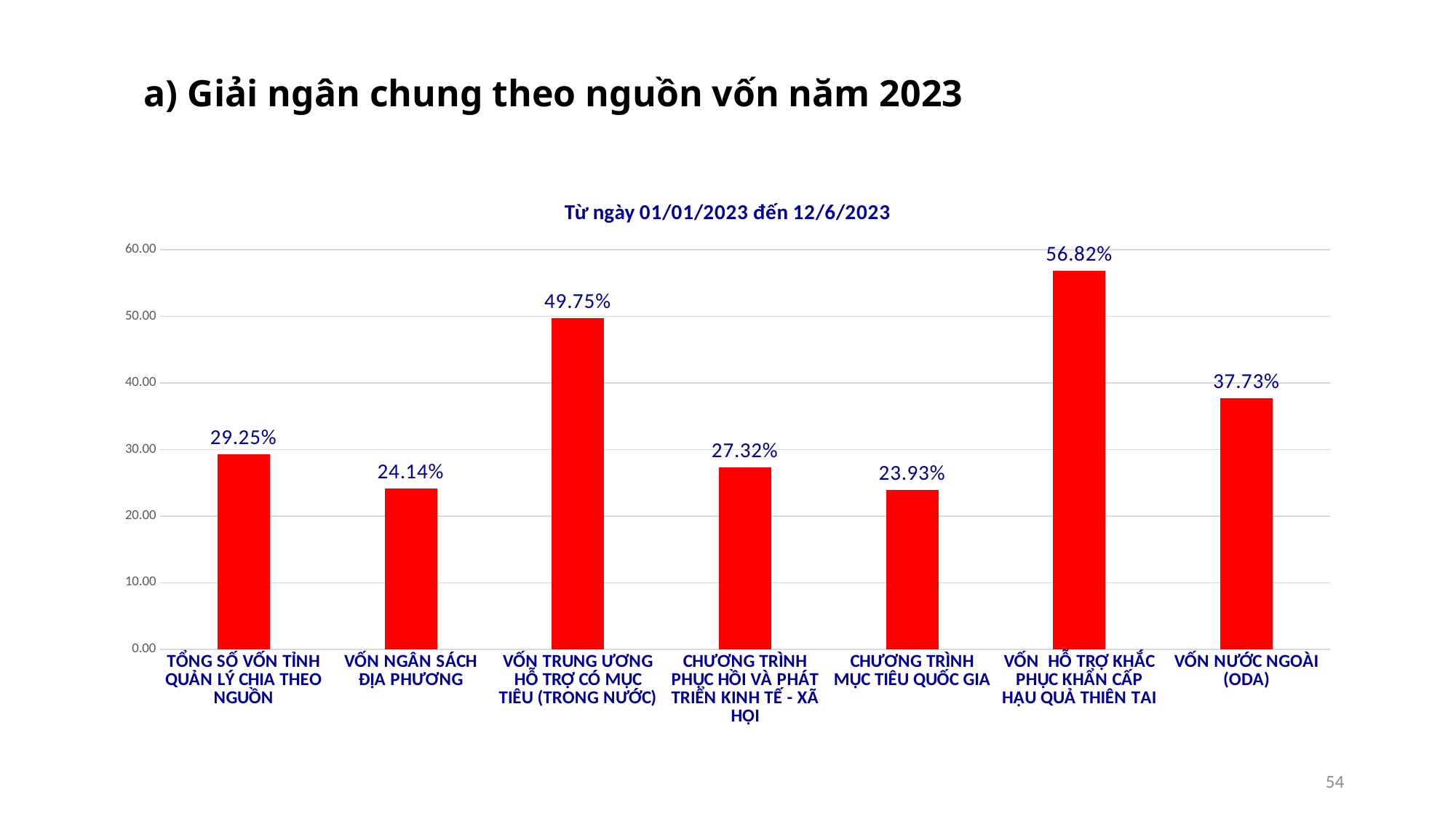
What is the title of the chart? Từ ngày 01/01/2023 đến 12/6/2023 What is the difference between the values for VỐN HỖ TRỢ KHẮC PHỤC KHẨN CẤP HẬU QUẢ THIÊN TAI and VỐN TRUNG ƯƠNG HỖ TRỢ CÓ MỤC TIÊU (TRONG NƯỚC)? 7.07% What kind of chart is shown on the slide? bar chart Which is larger: the value for TỔNG SỐ VỐN TỈNH QUẢN LÝ CHIA THEO NGUỒN or the value for CHƯƠNG TRÌNH PHỤC HỒI VÀ PHÁT TRIỂN KINH TẾ - XÃ HỘI? TỔNG SỐ VỐN TỈNH QUẢN LÝ CHIA THEO NGUỒN What is the value for CHƯƠNG TRÌNH MỤC TIÊU QUỐC GIA? 23.93% Which category has the highest value? VỐN HỖ TRỢ KHẮC PHỤC KHẨN CẤP HẬU QUẢ THIÊN TAI What colour are the bars in the chart? red What is the value for VỐN NƯỚC NGOÀI (ODA)? 37.73% How many categories are shown in the chart? 7 Is the value for VỐN TRUNG ƯƠNG HỖ TRỢ CÓ MỤC TIÊU (TRONG NƯỚC) greater or less than 40.00? greater Which category has the lowest value? CHƯƠNG TRÌNH MỤC TIÊU QUỐC GIA What is the value for VỐN NGÂN SÁCH ĐỊA PHƯƠNG? 24.14%